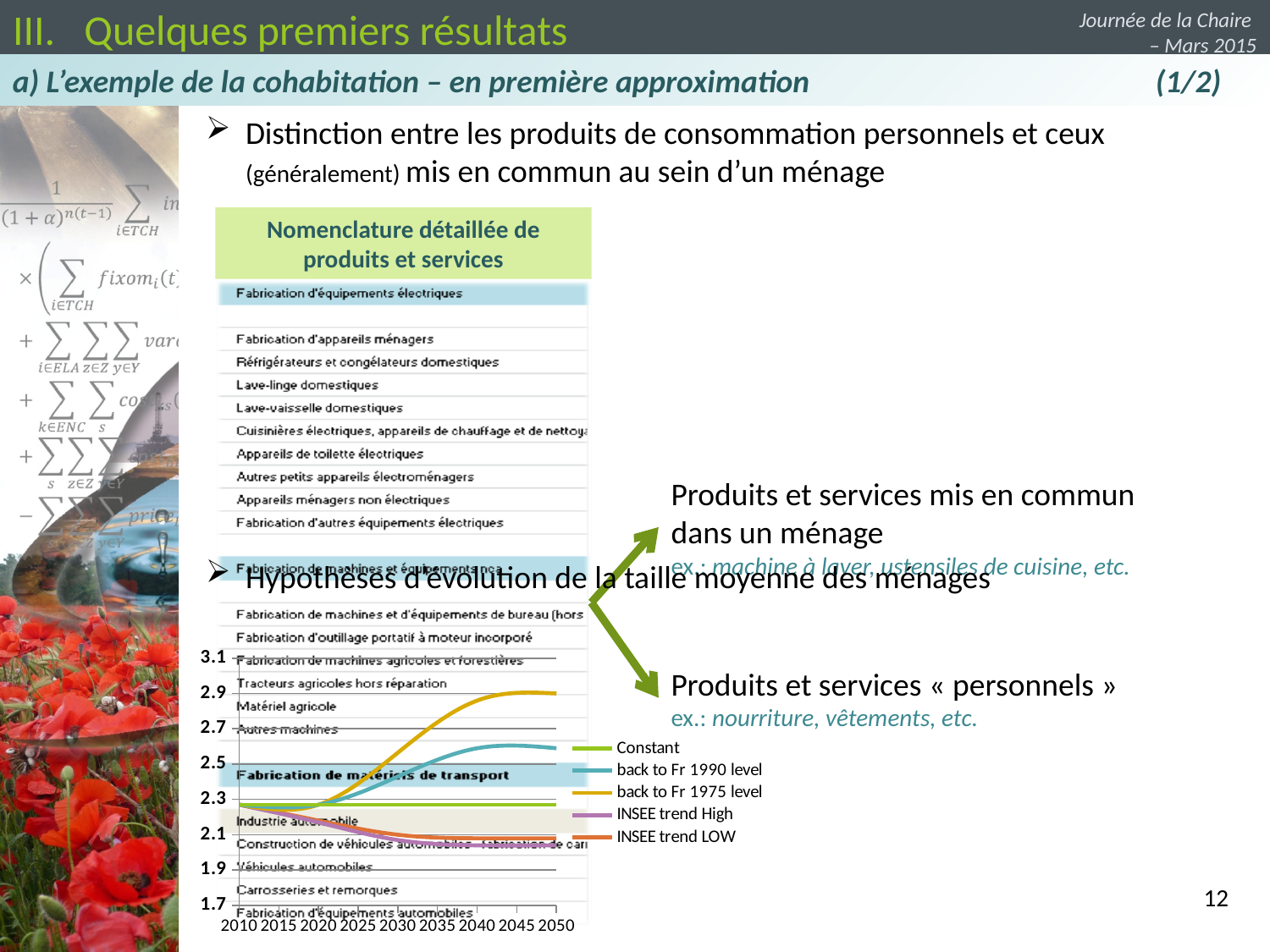
In the line chart, is the value of 'back to Fr 1990 level' in 2050 greater or less than 2.5? greater In the line chart, is the value of 'INSEE trend LOW' in 2050 greater or less than 2.3? less In the line chart, does the 'INSEE trend LOW' series rise or fall between 2015 and 2030? fall What is the first entry listed in the legend of the line chart? Constant Which series in the line chart reaches the highest value by 2050? back to Fr 1975 level How many series does the legend of the line chart list? 5 How many year ticks are shown on the x axis of the line chart? 9 In the line chart, is the value of 'back to Fr 1975 level' in 2050 greater or less than 2.7? greater In the line chart, which series is higher in 2050: 'Constant' or 'INSEE trend LOW'? Constant In the line chart, does the 'back to Fr 1975 level' series rise or fall between 2020 and 2040? rise In the line chart, which series is higher in 2050: 'back to Fr 1975 level' or 'back to Fr 1990 level'? back to Fr 1975 level What kind of chart is shown at the bottom left of the slide? line chart